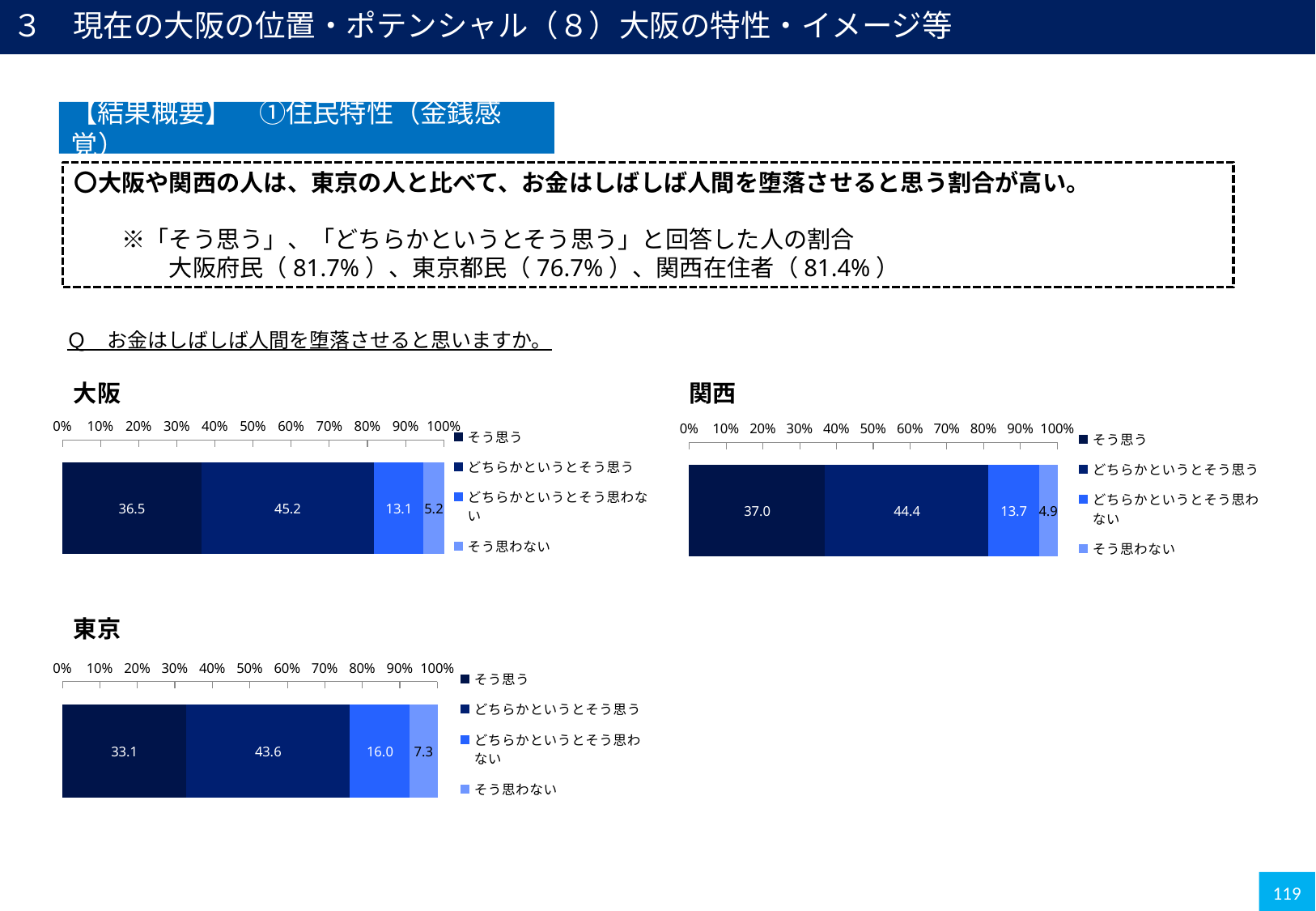
In the 東京 chart, what is the value for どちらかというとそう思わない? 16.0 How many charts are shown on the slide? 3 How many series does the legend of the 大阪 chart list? 4 In the 大阪 chart, which response category has the largest value? どちらかというとそう思う In the 大阪 chart, what is the value for そう思う? 36.5 Which is larger: the どちらかというとそう思わない value in the 東京 chart or in the 大阪 chart? 東京 In the 東京 chart, what is the value for そう思わない? 7.3 What is the difference between the そう思う value in the 関西 chart and the そう思う value in the 東京 chart? 3.9 In the 大阪 chart, what is the combined total of そう思う and どちらかというとそう思う? 81.7 What kind of chart is the 東京 chart? Stacked bar chart In the 関西 chart, what is the value for どちらかというとそう思う? 44.4 In the 関西 chart, which response category has the smallest value? そう思わない